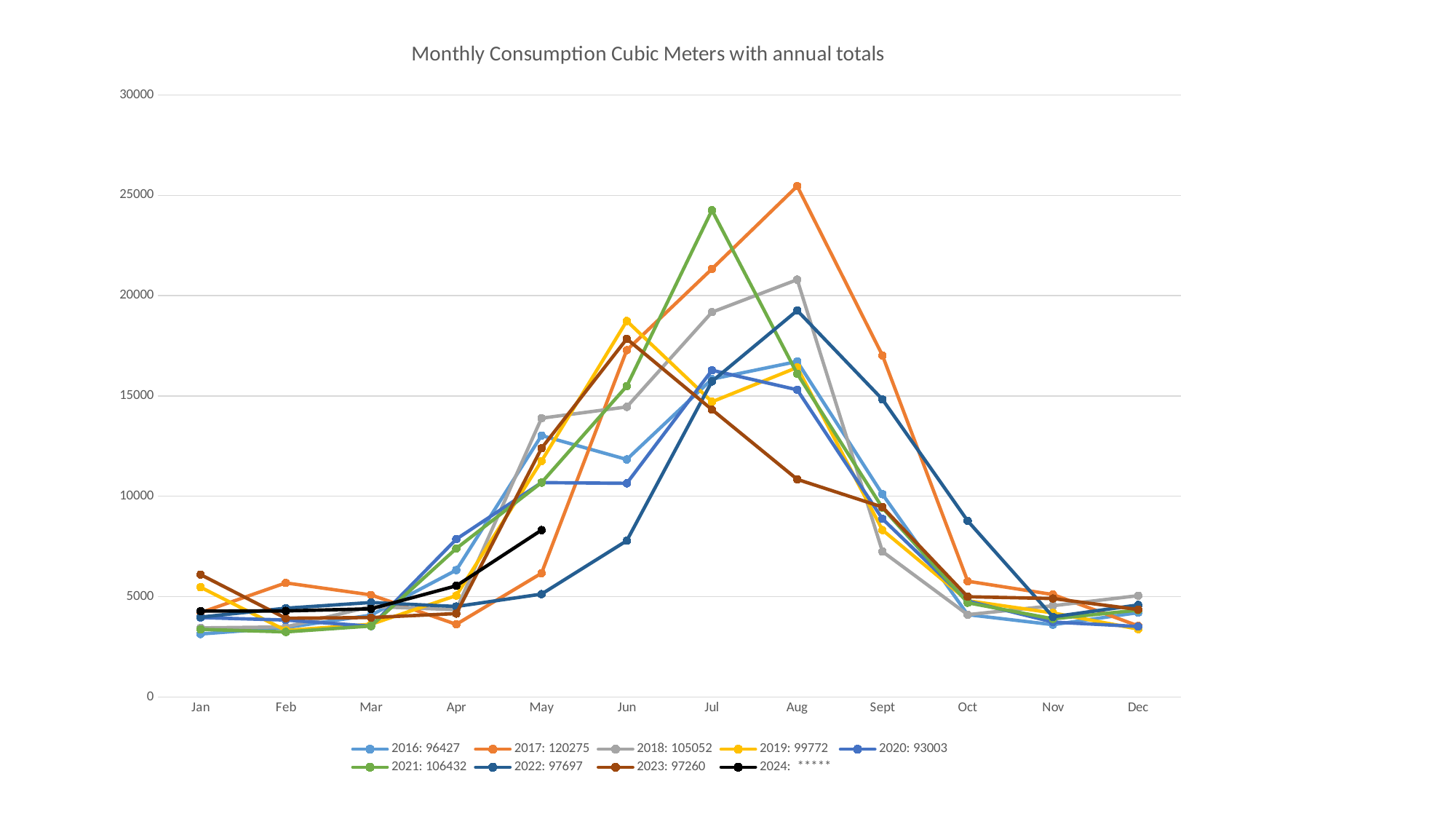
How many months are shown along the x axis? 12 Which is larger: the 2017 value in Aug or the 2021 value in Jul? 2017 value in Aug Does the 2024 series rise or fall from Jan to May? rise In which month does the 2017 series reach its highest value? Aug How many series does the legend list? 9 According to the legend, what is the annual total for 2017? 120275 Is the value for 2022 in Jun greater or less than 10000? less What kind of chart is shown on the slide? line chart In which month does the 2021 series reach its highest value? Jul How many monthly data points are plotted for the 2024 series? 5 What is the title of the chart? Monthly Consumption Cubic Meters with annual totals Is the value for 2017 in Aug greater or less than 20000? greater